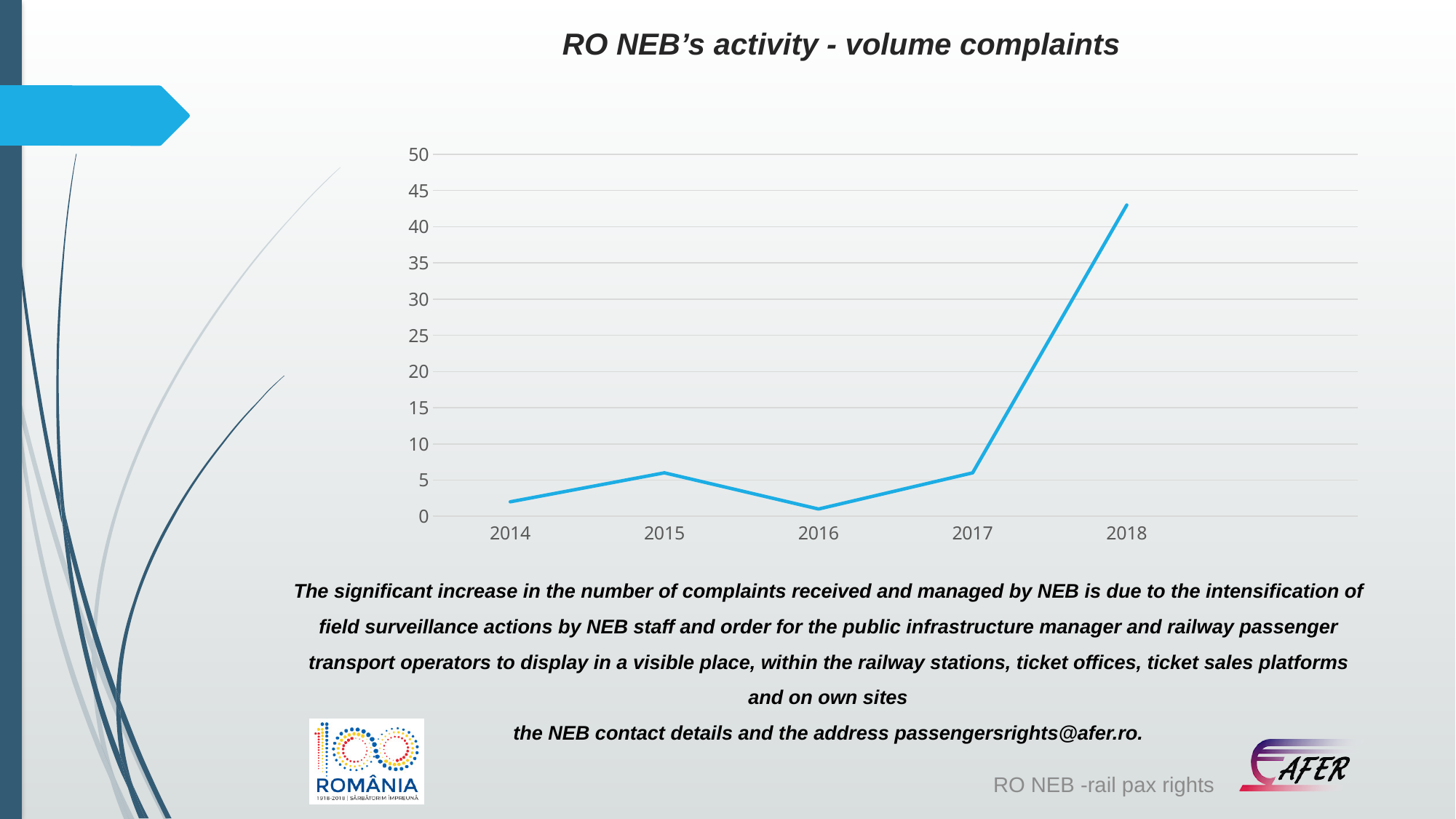
What kind of chart is shown on the slide? line chart Does the line rise or fall between 2015 and 2016? fall Does the line rise or fall between 2017 and 2018? rise Is the value for 2017 greater or less than 10? less Is the value for 2014 greater or less than 5? less Is the value for 2015 greater or less than 10? less How many years are plotted on the x axis of the chart? 5 Which year has the highest number of complaints? 2018 Which is larger, the value for 2017 or the value for 2018? 2018 What is the title of the chart on the slide? RO NEB's activity - volume complaints